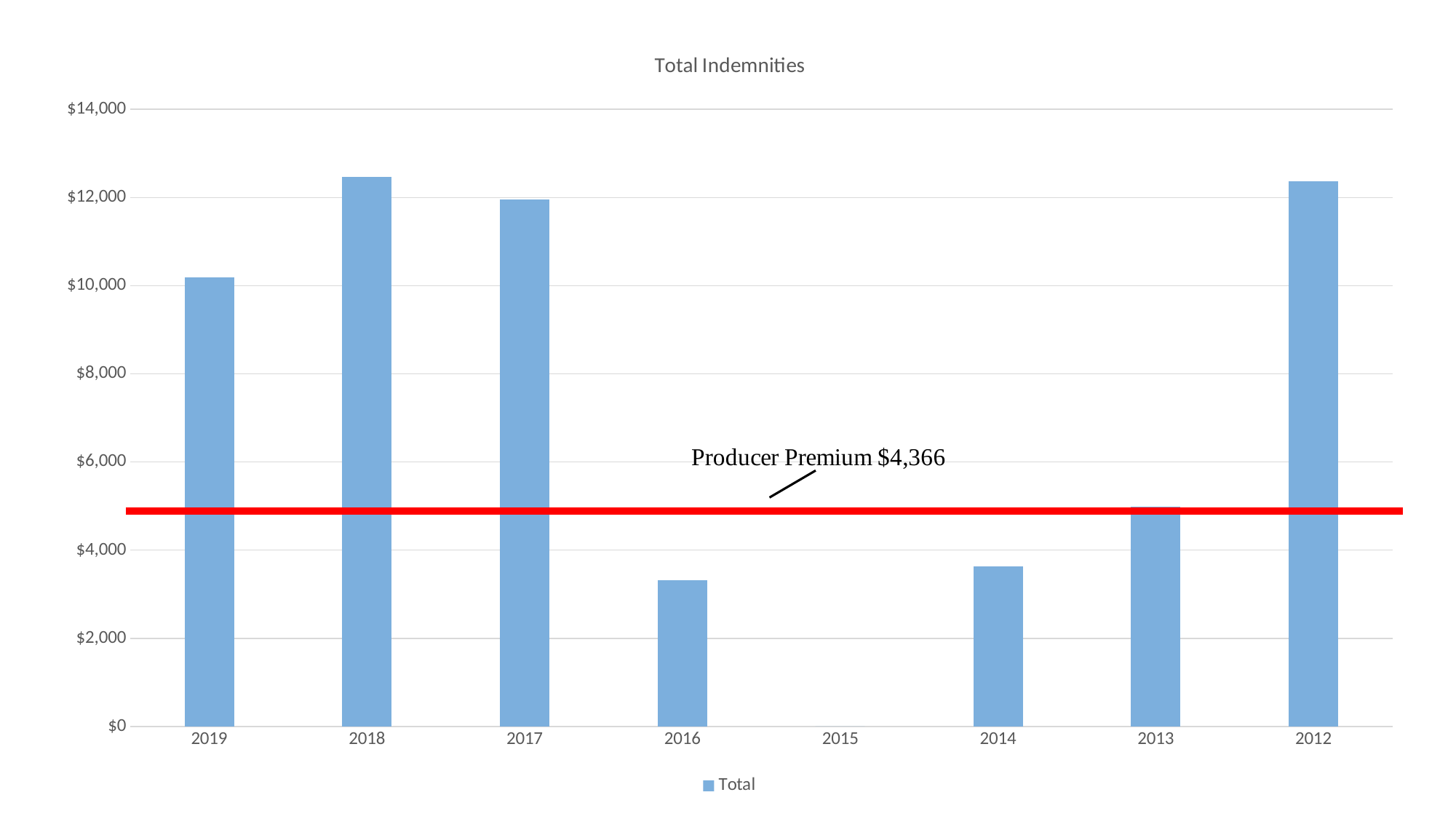
Which year has the larger value, 2016 or 2014? 2014 Is the value for 2014 greater or less than $4,000? less What kind of chart is shown on the slide? bar chart Is the value for 2019 greater or less than $10,000? greater How many series does the legend list? 1 Is the value for 2018 greater or less than $12,000? greater Which year has the larger value, 2019 or 2018? 2018 How many years are shown on the x axis of the chart? 8 What is the title of the chart? Total Indemnities Which year shows no bar at all? 2015 What value does the Producer Premium annotation give? $4,366